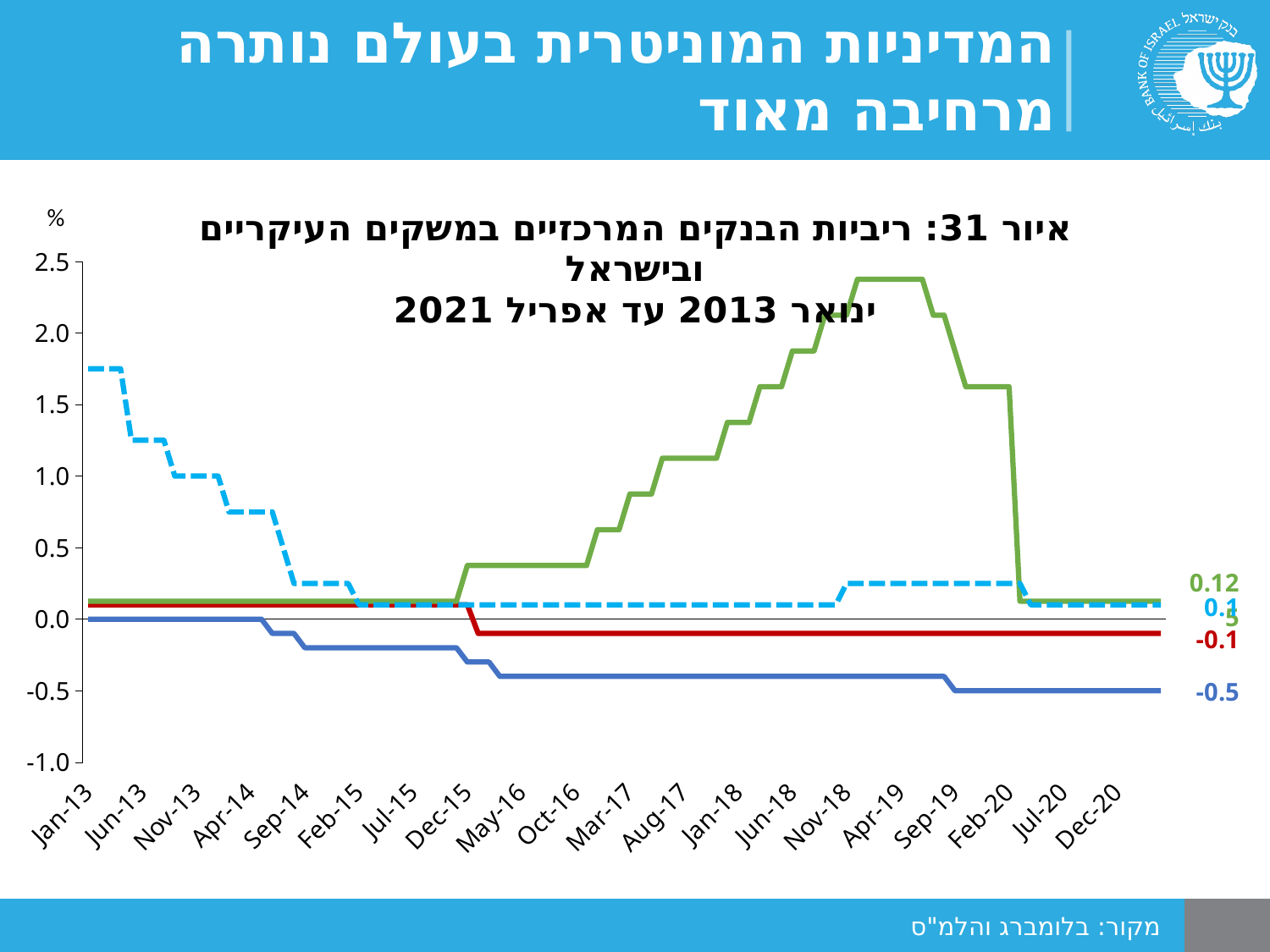
How many lines are plotted on the chart? 4 Which line has the lowest value at the end of the period? the solid blue line What kind of chart is shown on the slide? line chart Does the dashed blue line rise or fall between Jan-13 and Feb-15? fall What unit is shown on the vertical axis of the chart? % What is the difference between the final labelled values of the green line (0.12) and the solid blue line (-0.5)? 0.62 What is the final value labelled at the end of the red line? -0.1 What is the final value labelled at the end of the solid blue line? -0.5 Is the peak value of the green line greater or less than 2.0? greater At the end of the period, which is larger: the red line's value or the solid blue line's value? the red line Which line reaches the highest value on the chart? the green line What is the final value labelled at the end of the green line? 0.125